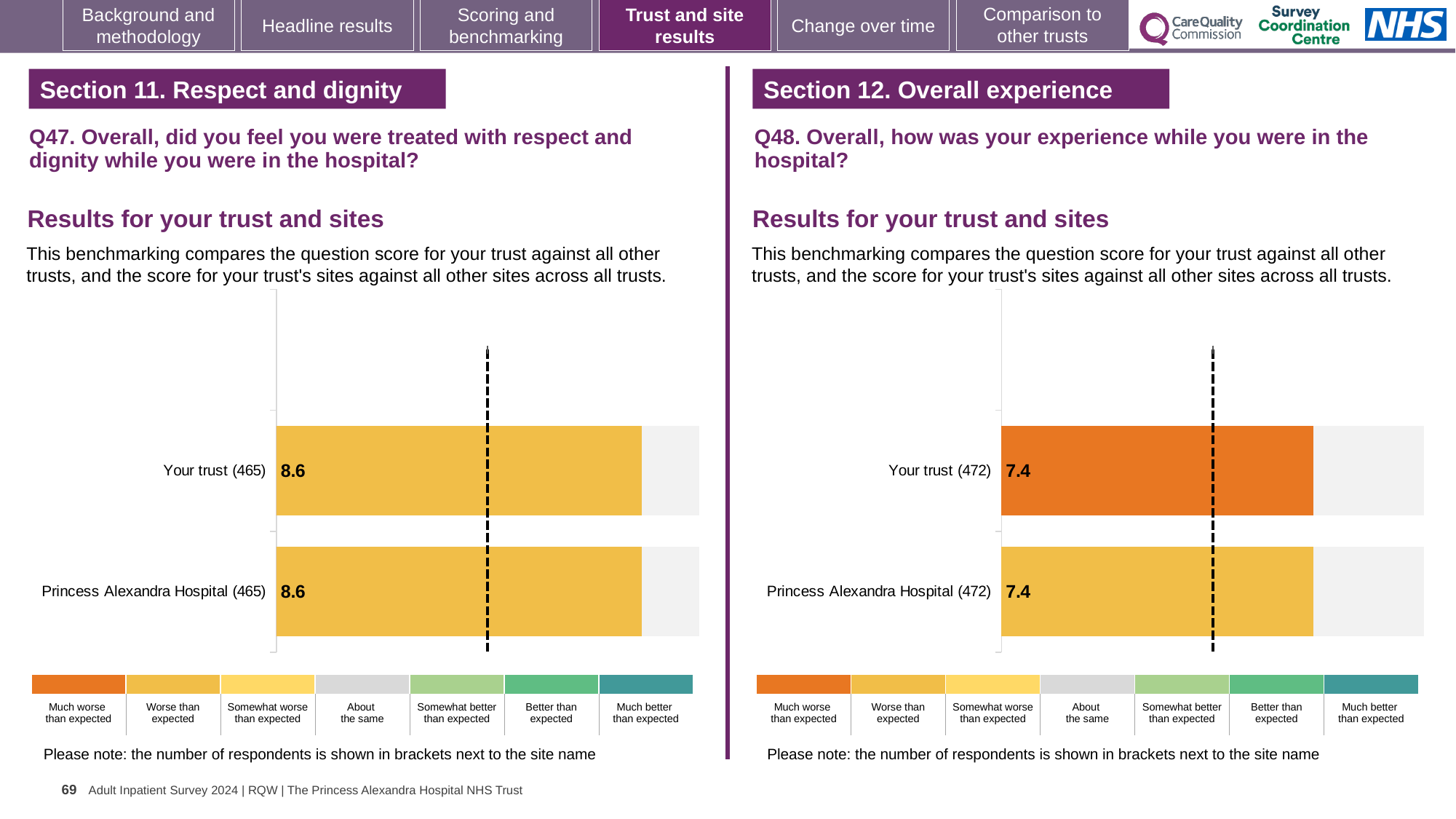
On the Q47 chart (left), which benchmark category does the colour of the Princess Alexandra Hospital bar correspond to? Worse than expected On the Q47 chart (left), what is the score for Princess Alexandra Hospital? 8.6 What kind of chart is used on the Q48 chart (right)? Bar chart On the Q48 chart (right), how many respondents are shown in brackets for Princess Alexandra Hospital? 472 On the Q47 chart (left), how many respondents are shown in brackets for Your trust? 465 On the Q48 chart (right), which benchmark category does the colour of the Your trust bar correspond to? Much worse than expected On the Q48 chart (right), what is the score for Princess Alexandra Hospital? 7.4 On the Q47 chart (left), what is the score for Your trust? 8.6 On the Q47 chart (left), how many bars are plotted? 2 On the Q48 chart (right), what is the score for Your trust? 7.4 On the Q48 chart (right), what is the difference between the score for Your trust and the score for Princess Alexandra Hospital? 0.0 Is the Your trust score on the Q47 chart (left) larger or smaller than the Your trust score on the Q48 chart (right)? Larger